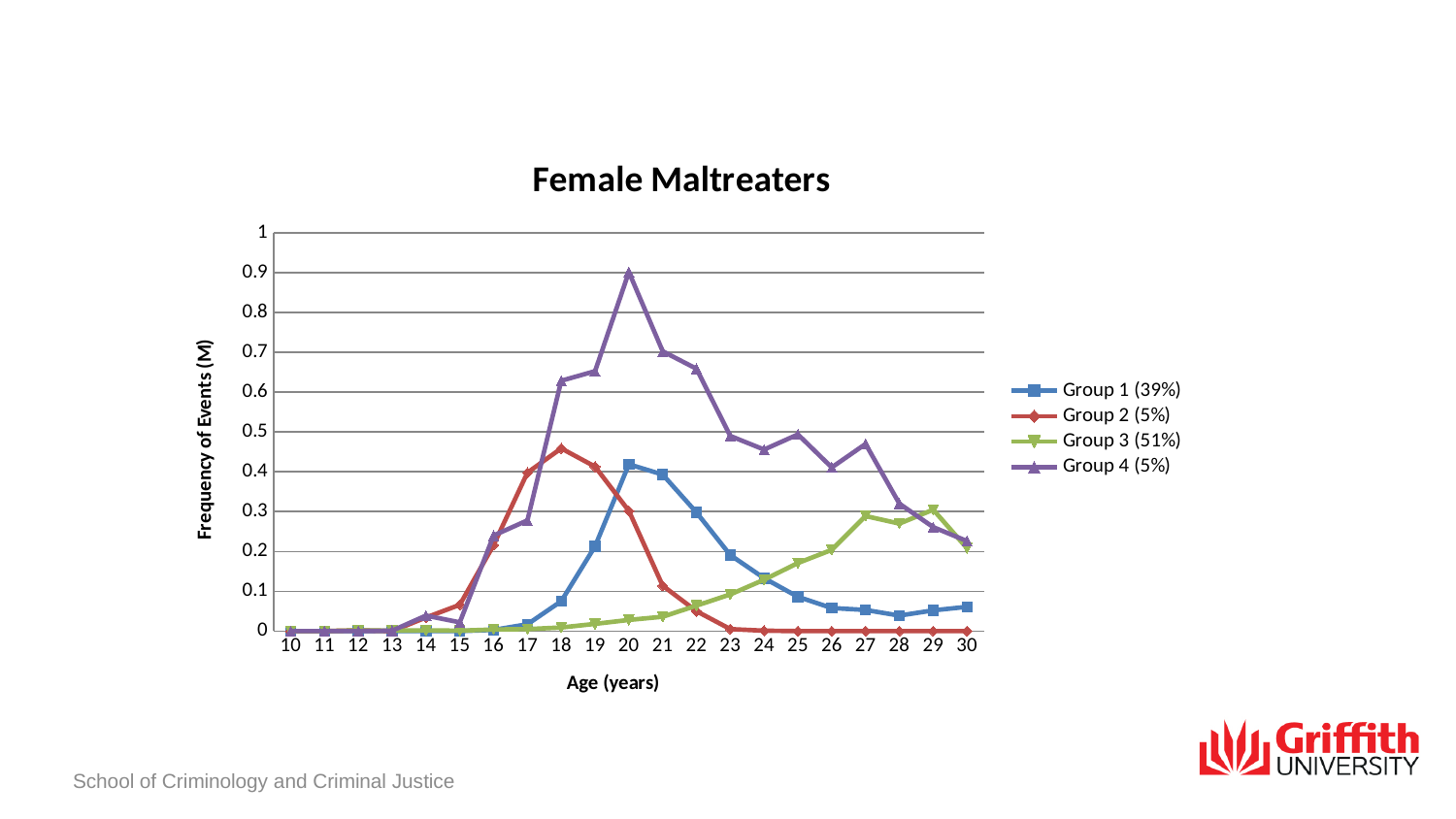
At which age does Group 4 (5%) reach its peak? 20 Is the value for Group 2 (5%) at age 18 greater or less than 0.4? greater Is the value for Group 1 (39%) at age 28 greater or less than 0.1? less At age 18, which is larger: Group 2 (5%) or Group 4 (5%)? Group 4 (5%) How many age values are shown along the x axis? 21 What kind of chart is shown on the slide? Line chart How many series does the legend list? 4 Is the value for Group 4 (5%) at age 20 greater or less than 0.8? greater Does the value for Group 3 (51%) rise or fall between ages 20 and 27? rise Which group reaches the highest frequency of events at any age? Group 4 (5%) At age 30, which is larger: Group 1 (39%) or Group 3 (51%)? Group 3 (51%) At which age does Group 2 (5%) reach its peak? 18